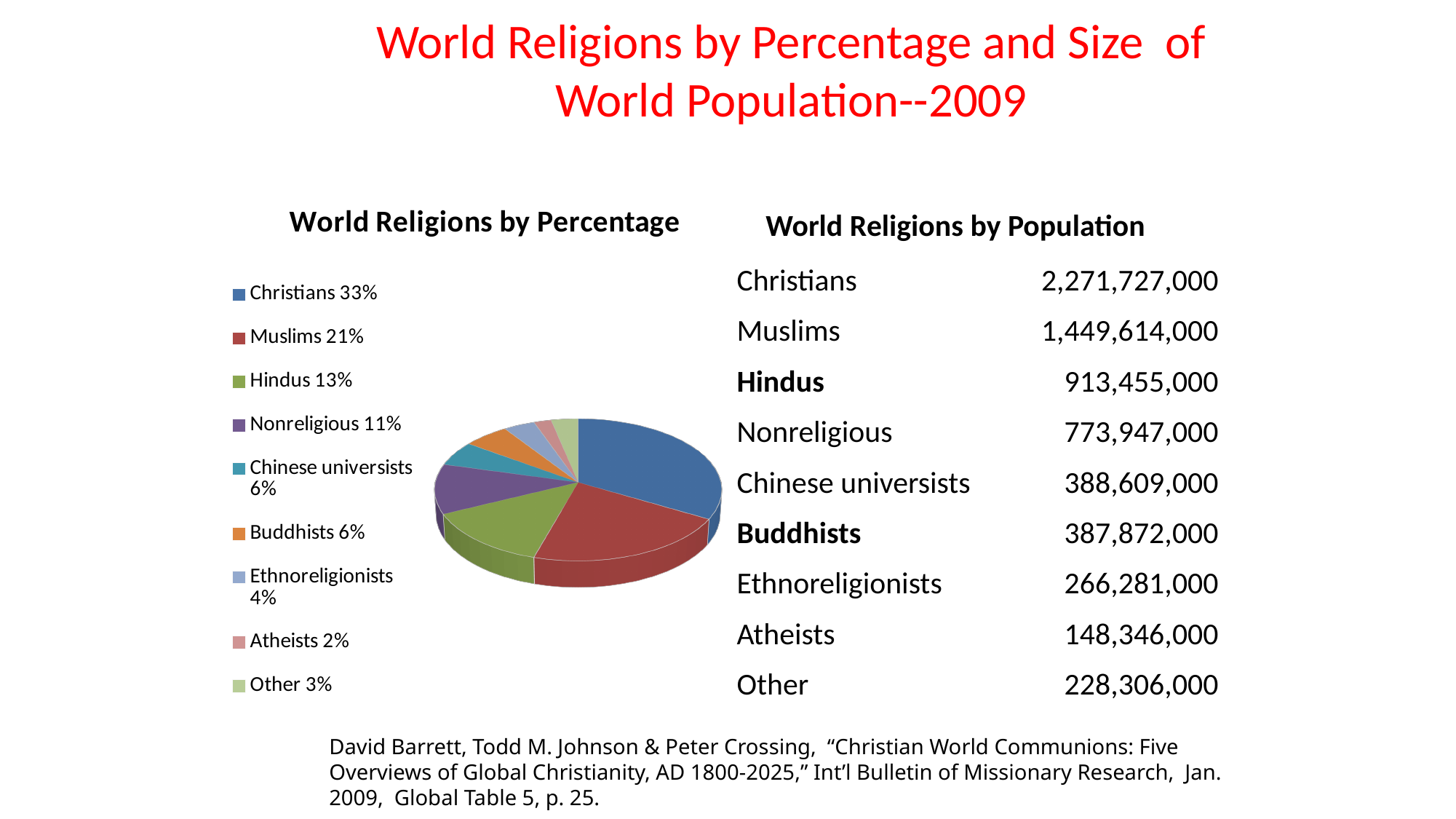
Which category has the largest slice of the pie? Christians What is the title of the chart? World Religions by Percentage What kind of chart is shown on the slide? pie chart Which slice is larger, Hindus or Nonreligious? Hindus What is the difference in percentage points between Christians and Muslims? 12 How many categories does the pie chart's legend list? 9 What percentage does the legend give for Ethnoreligionists? 4% What percentage does the legend give for Muslims? 21% What percentage does the legend give for Nonreligious? 11% Which category has the smallest slice of the pie? Atheists What colour is the Christians slice in the pie chart? blue What percentage does the legend give for Christians? 33%